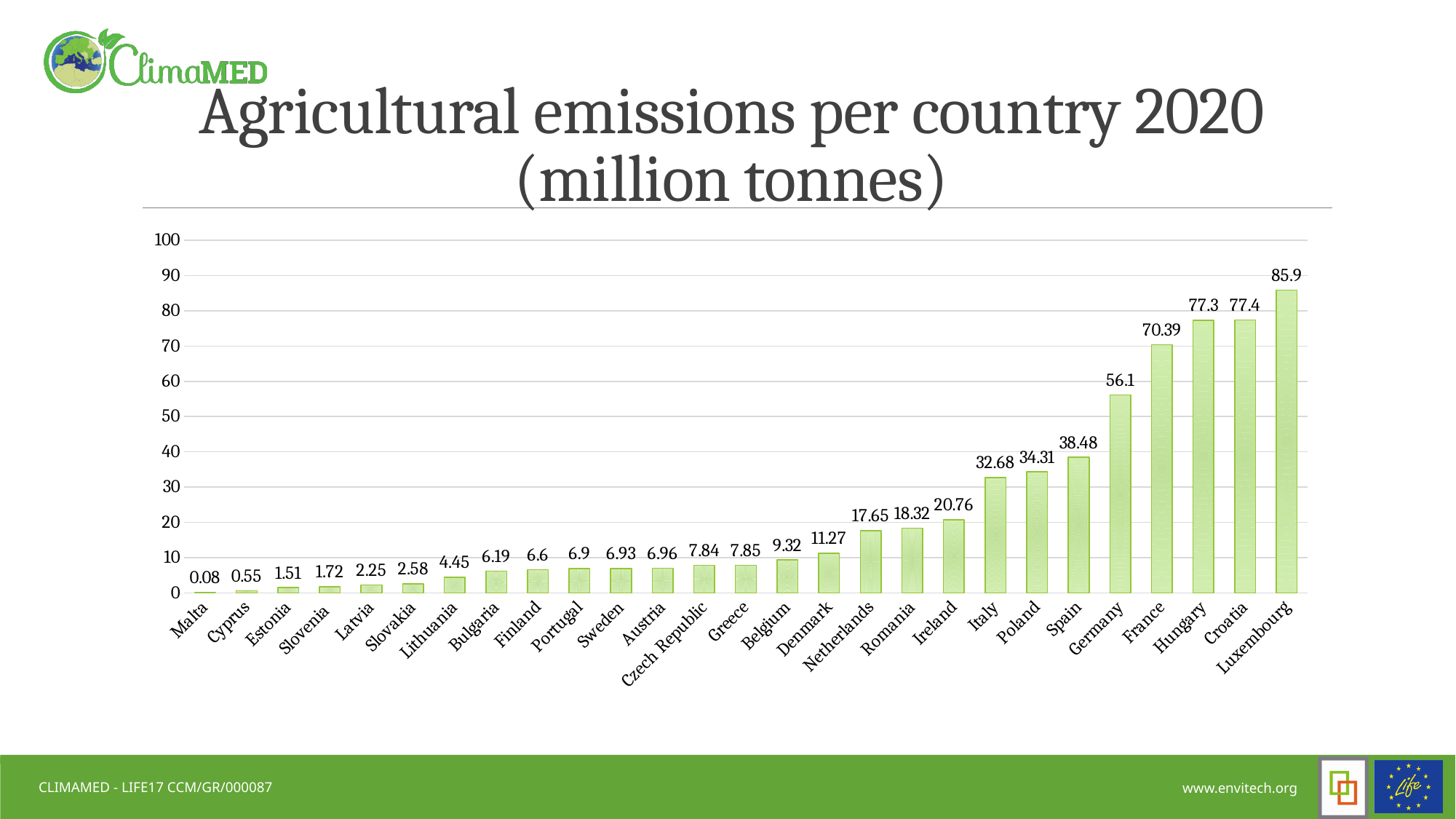
How many countries are shown in the chart? 27 What is the difference between the values for Germany and Spain? 17.62 What is the value for Netherlands? 17.65 What is the difference between the values for Luxembourg and Malta? 85.82 What is the title of the chart? Agricultural emissions per country 2020 (million tonnes) Which is larger, the value for Italy or the value for Poland? Poland What is the value for Malta? 0.08 What is the value for Germany? 56.1 Is the value for France greater or less than 60? greater What kind of chart is shown on the slide? bar chart Which country has the highest agricultural emissions? Luxembourg Which country has the lowest agricultural emissions? Malta